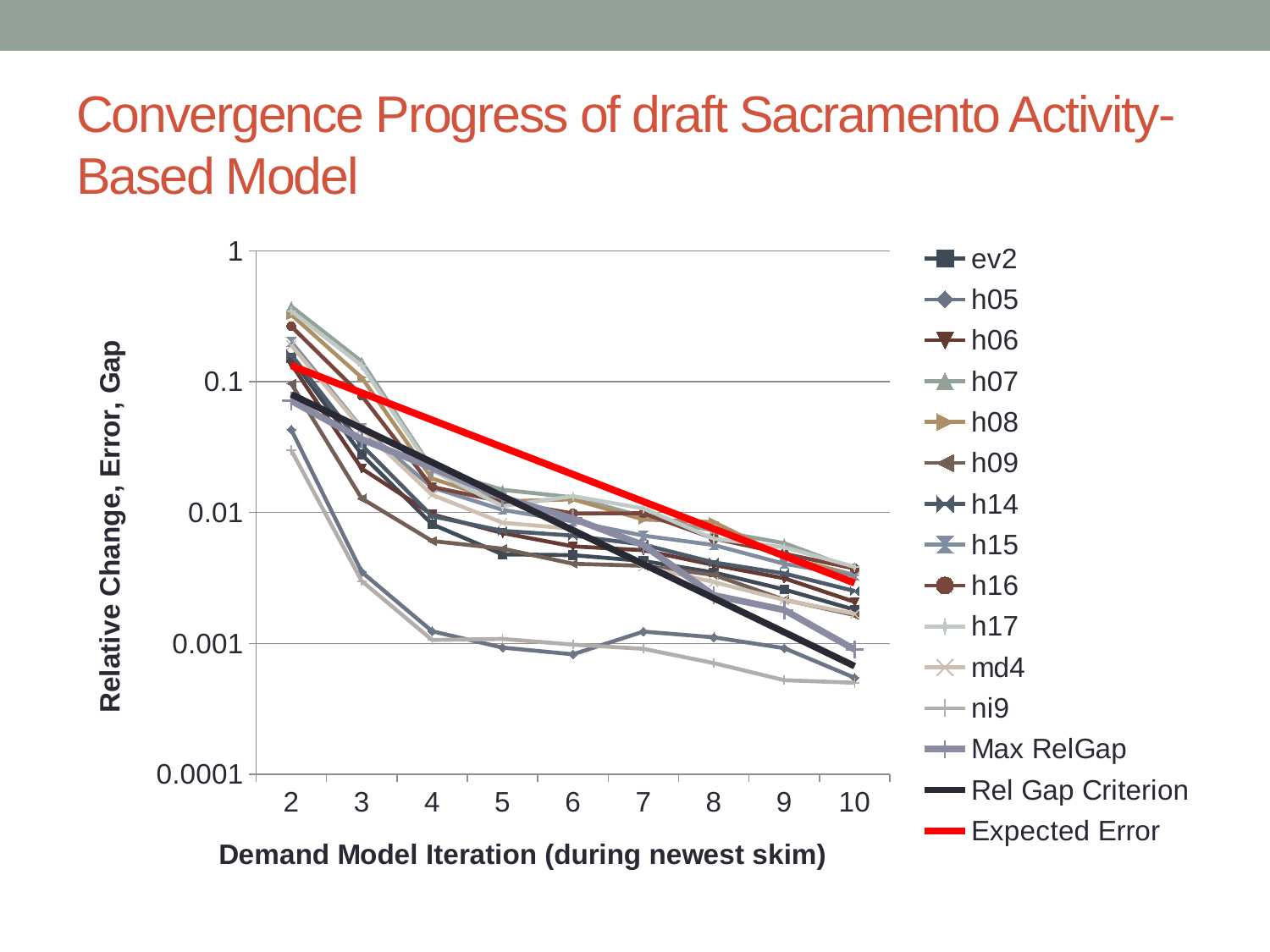
How many series does the legend list? 15 How many demand model iterations are shown along the x axis? 9 What colour is the Expected Error line? red At iteration 10, which is larger: the Expected Error line or the Rel Gap Criterion line? Expected Error Is the value of the Expected Error line at iteration 10 greater or less than 0.001? greater What kind of chart is shown on the slide? line chart Is the value for h05 at iteration 2 greater or less than 0.1? less Is the value for ni9 at iteration 10 greater or less than 0.001? less What is the title of the y axis? Relative Change, Error, Gap Do the values of the Expected Error line rise or fall as the iteration number increases? fall